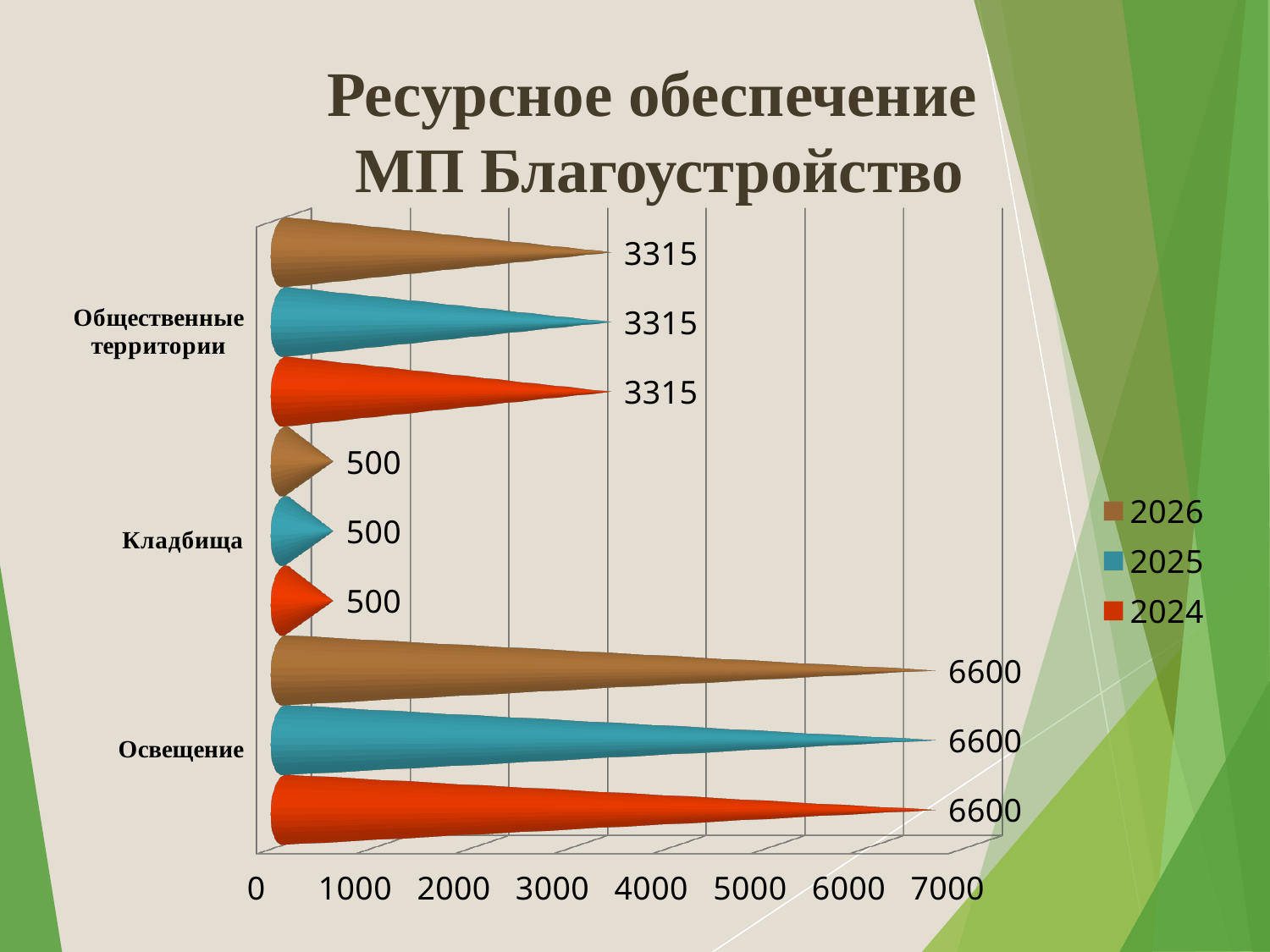
What is the value for Освещение in 2024? 6600 Which category has the lowest value in 2026? Кладбища What is the difference between the 2024 values for Освещение and Общественные территории? 3285 What is the value for Общественные территории in 2026? 3315 Which is larger in 2026: Общественные территории or Кладбища? Общественные территории Is the value for Освещение in 2026 greater or less than 6000? greater What is the title of the chart? Ресурсное обеспечение МП Благоустройство How many categories are shown on the chart? 3 Which category has the highest value in 2025? Освещение How many series does the legend list? 3 What kind of chart is shown on the slide? bar chart What is the value for Кладбища in 2025? 500